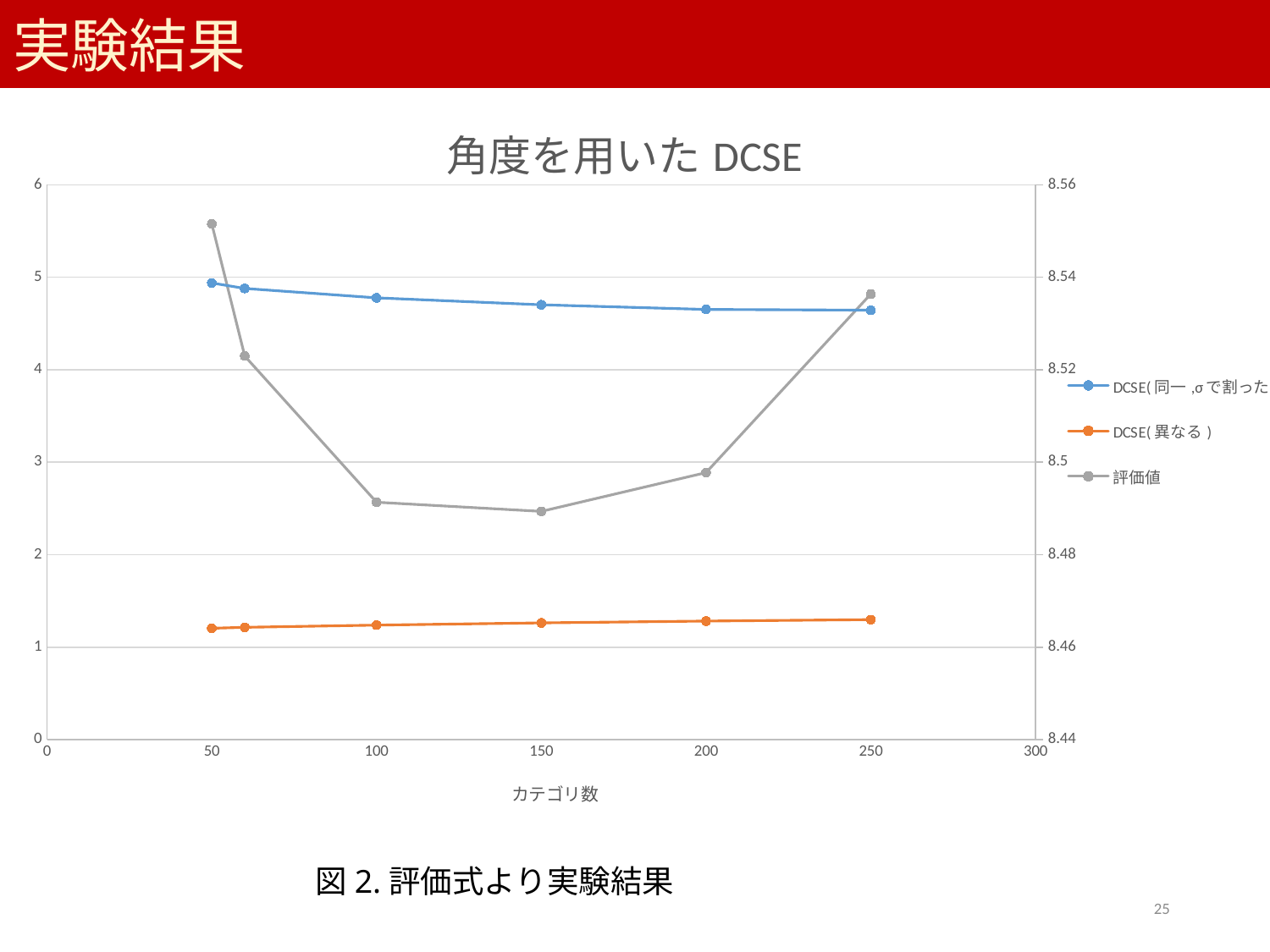
How many data points are plotted for the 評価値 series? 6 What is the label of the x axis? カテゴリ数 Does the DCSE(異なる) series rise or fall as カテゴリ数 increases from 50 to 250? rise At カテゴリ数 = 250, which series has the larger value on the left axis: DCSE(同一,σで割った) or DCSE(異なる)? DCSE(同一,σで割った) On the left axis, is the value of DCSE(同一,σで割った) at カテゴリ数 = 100 greater or less than 4? greater Does the DCSE(同一,σで割った) series rise or fall as カテゴリ数 increases from 50 to 250? fall How many series does the legend list? 3 Which series is drawn in orange? DCSE(異なる) What kind of chart is shown on the slide? line chart At which カテゴリ数 value is the 評価値 series highest? 50 On the left axis, is the value of DCSE(異なる) at カテゴリ数 = 50 greater or less than 2? less What is the title of the chart? 角度を用いた DCSE